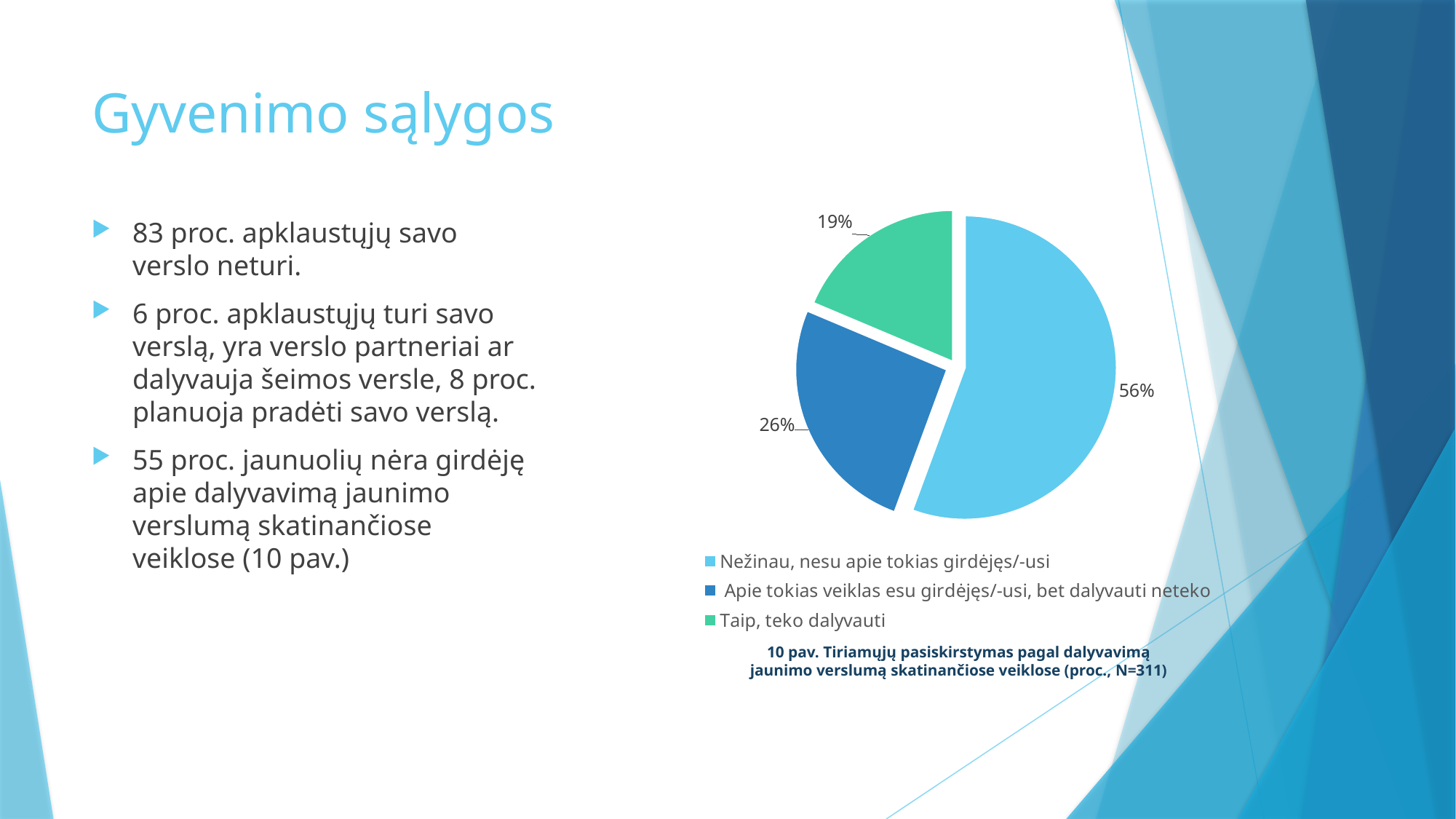
How many entries does the legend list? 3 What colour is the "Taip, teko dalyvauti" slice? green What share of the pie does "Apie tokias veiklas esu girdėjęs/-usi, bet dalyvauti neteko" have? 26% What share of the pie does "Nežinau, nesu apie tokias girdėjęs/-usi" have? 56% Which category has the smallest slice of the pie? Taip, teko dalyvauti What sample size (N) is stated in the chart caption? N=311 What share of the pie does "Taip, teko dalyvauti" have? 19% Which category has the largest slice of the pie? Nežinau, nesu apie tokias girdėjęs/-usi What type of chart is shown on the slide? pie chart Which slice is larger: "Apie tokias veiklas esu girdėjęs/-usi, bet dalyvauti neteko" or "Taip, teko dalyvauti"? Apie tokias veiklas esu girdėjęs/-usi, bet dalyvauti neteko How many slices does the pie chart have? 3 What is the difference in percentage points between the "Nežinau, nesu apie tokias girdėjęs/-usi" slice and the "Taip, teko dalyvauti" slice? 37 percentage points